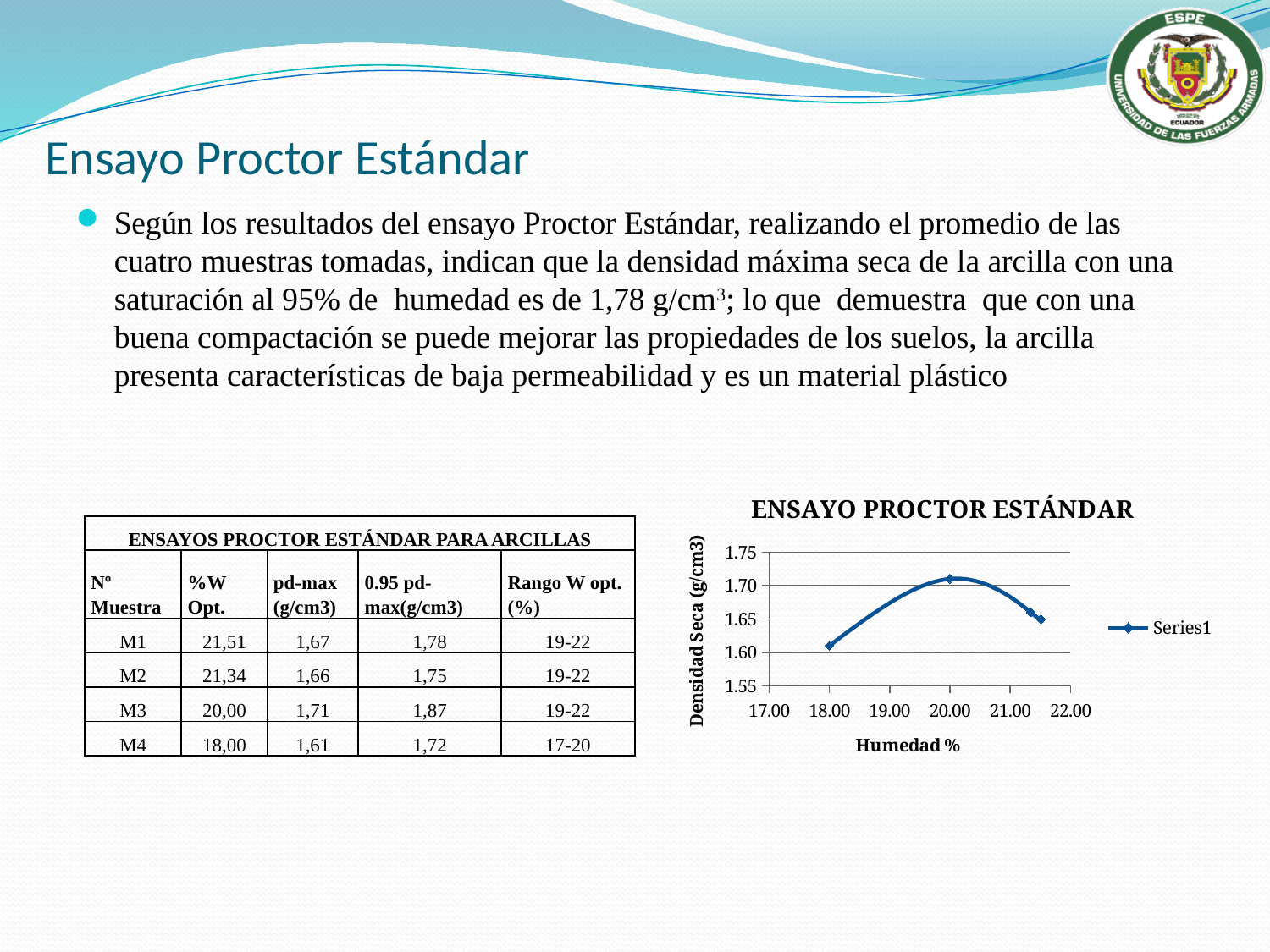
What is the title of the chart on the right of the slide? ENSAYO PROCTOR ESTÁNDAR How does Densidad Seca change as Humedad % increases along the x axis? rises then falls How many series does the legend of the chart list? 1 Which has the larger Densidad Seca on the chart: Humedad 18.00 or Humedad 20.00? 20.00 What kind of chart is shown under the title ENSAYO PROCTOR ESTÁNDAR? line chart At which Humedad % value does the chart reach its highest Densidad Seca? 20.00 Is the Densidad Seca value at Humedad 20.00 greater or less than 1.70? greater Is the Densidad Seca value at Humedad 18.00 greater or less than 1.65? less At which Humedad % value does the chart show its lowest Densidad Seca? 18.00 How many data points are plotted on the chart? 4 Is the Densidad Seca value at Humedad 18.00 greater or less than 1.55? greater What is the legend entry shown on the chart? Series1